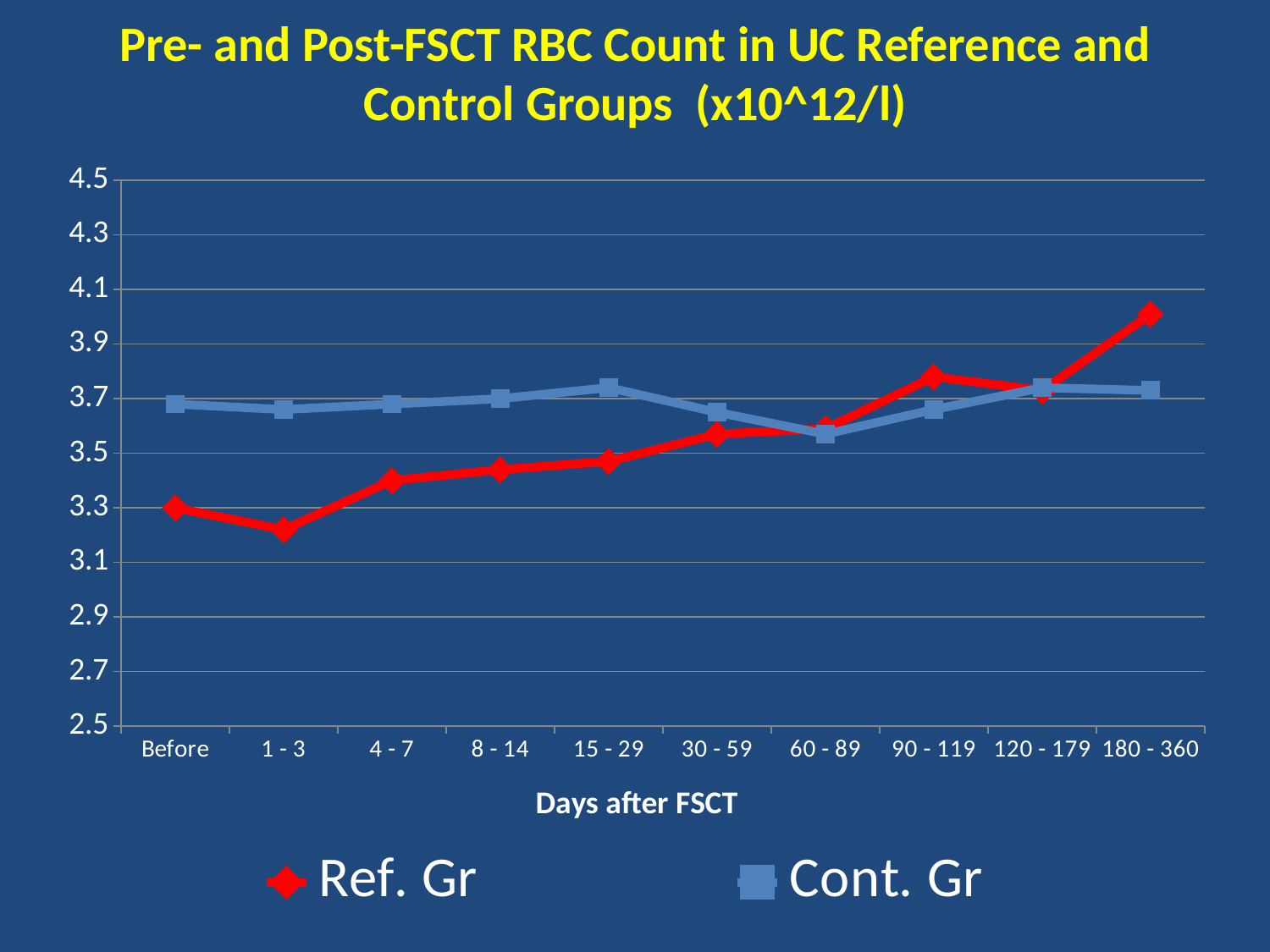
Which series has the higher value at 'Before', Ref. Gr or Cont. Gr? Cont. Gr Is the value for Ref. Gr at 'Before' greater or less than 3.5? less Is the value for Ref. Gr at '180 - 360' greater or less than 3.9? greater What kind of chart is shown on the slide? line chart Which series has the higher value at '180 - 360', Ref. Gr or Cont. Gr? Ref. Gr How many series does the legend list? 2 Does the Ref. Gr series generally rise or fall from 'Before' to '180 - 360'? rise Is the value for Cont. Gr at '60 - 89' greater or less than 3.7? less At which category does the Ref. Gr series reach its highest value? 180 - 360 What is the title of the x axis? Days after FSCT At which category does the Ref. Gr series have its lowest value? 1 - 3 How many categories are shown along the x axis? 10